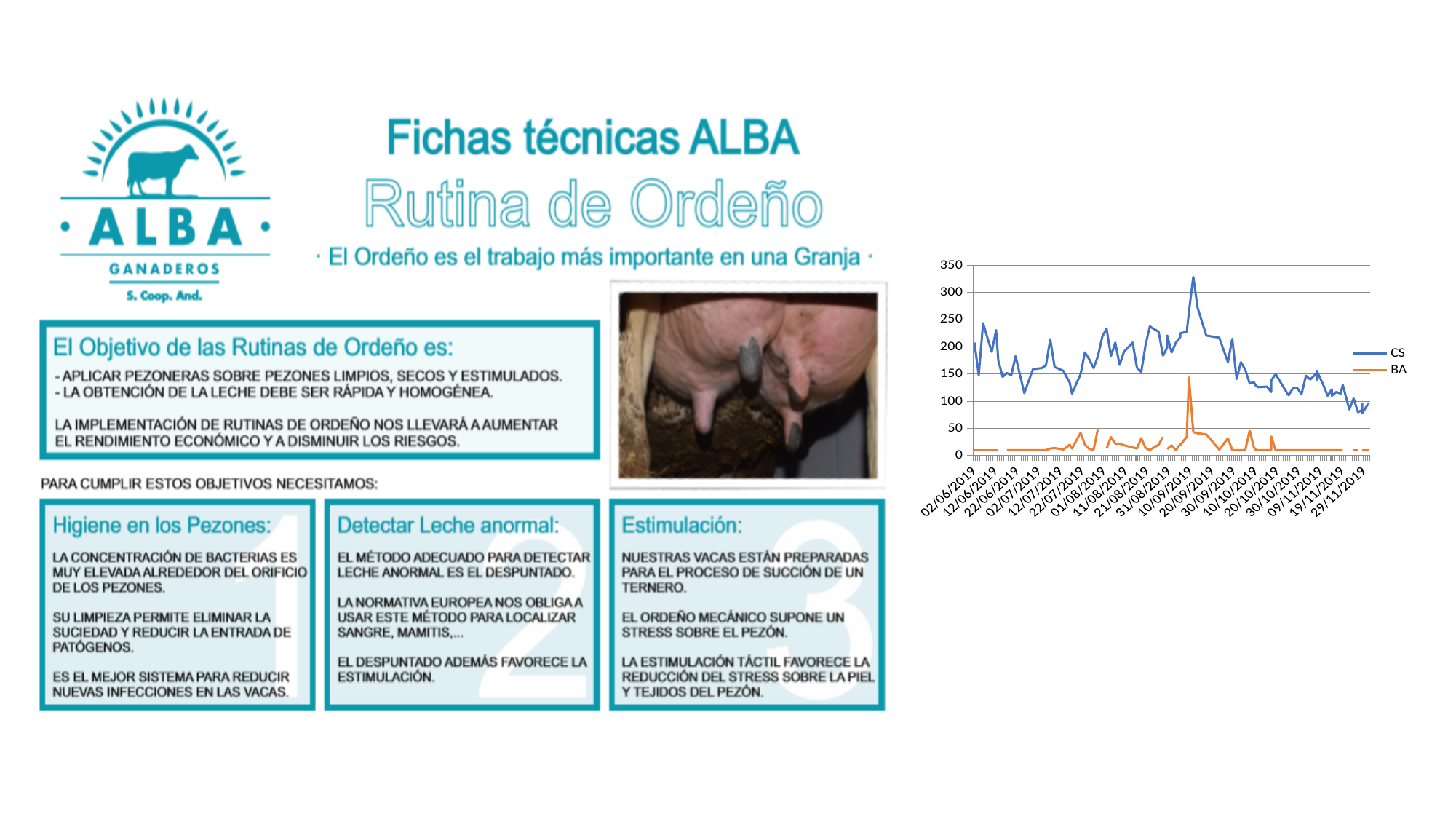
Around 20/09/2019, which series has the larger value, CS or BA? CS What are the two series named in the chart legend? CS and BA Does the CS series rise or fall between mid-September 2019 and the end of November 2019? fall Are the BA values in November 2019 greater or less than 50? less How many series does the legend of the chart list? 2 Is the highest value of the BA series greater or less than 100? greater Is the value for CS on 02/06/2019 greater or less than 150? greater What kind of chart is shown on the right side of the slide? line chart What is the first date shown on the x axis of the chart? 02/06/2019 Which series in the chart has the higher values overall, CS or BA? CS